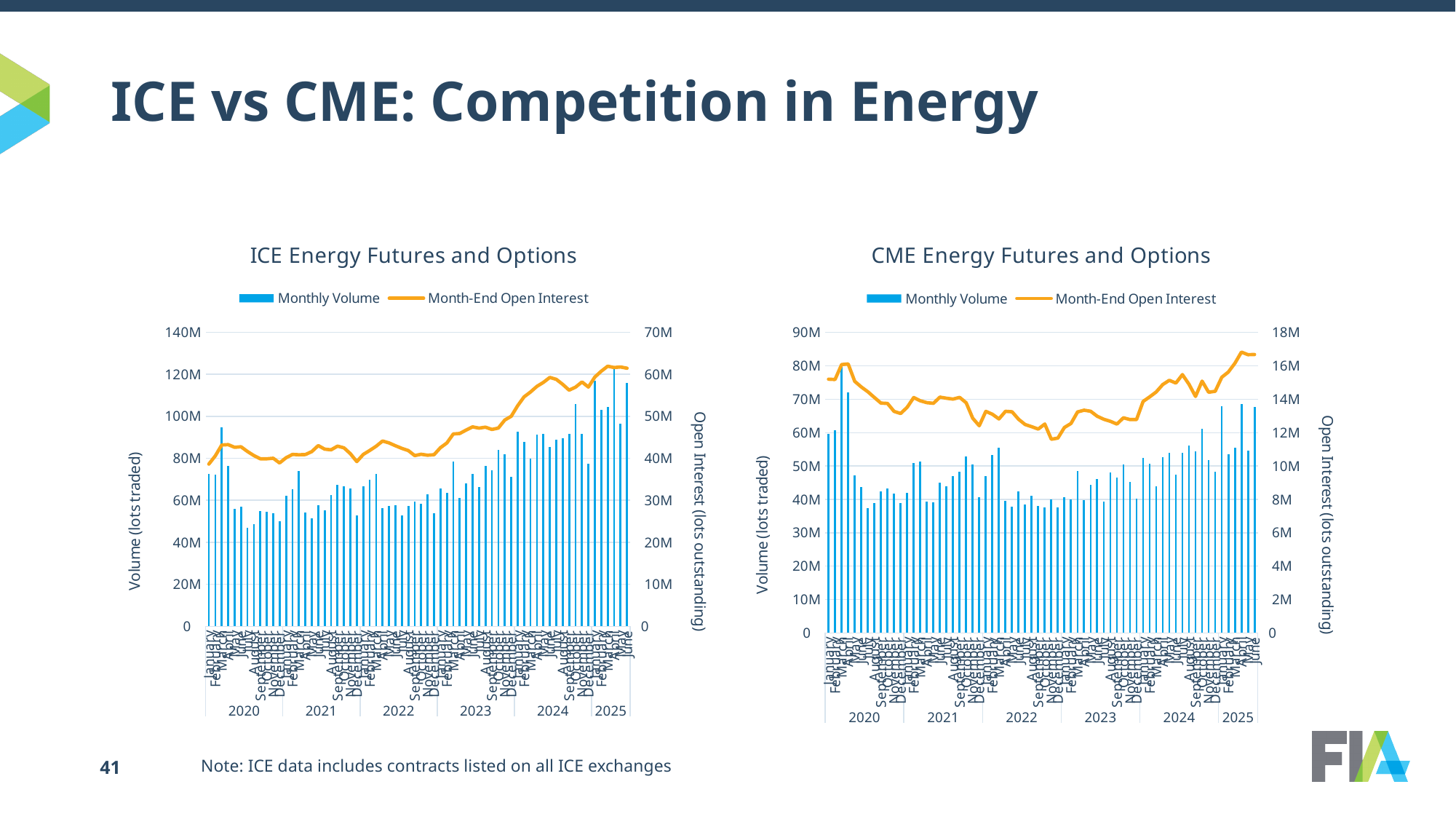
How many years are labelled along the x axis of the CME Energy Futures and Options chart? 6 On the ICE Energy Futures and Options chart, how many series does the legend list? 2 What kind of chart is the ICE Energy Futures and Options chart? A combination bar and line chart On the ICE Energy Futures and Options chart, is the Month-End Open Interest at the end of the series (2025) greater or less than 50M? greater On the CME Energy Futures and Options chart, which series is drawn as a line? Month-End Open Interest On the CME Energy Futures and Options chart, is the Month-End Open Interest at the end of the series (2025) greater or less than 14M? greater On the ICE Energy Futures and Options chart, is the tallest Monthly Volume bar in 2025 greater or less than 100M? greater On the CME Energy Futures and Options chart, does the Month-End Open Interest line rise or fall from 2023 to 2025? Rise On the CME Energy Futures and Options chart, does the Month-End Open Interest line generally rise or fall from 2020 to 2022? Fall On the CME Energy Futures and Options chart, what are the two series named in the legend? Monthly Volume and Month-End Open Interest On the ICE Energy Futures and Options chart, does the Month-End Open Interest line rise or fall from 2023 to 2025? Rise